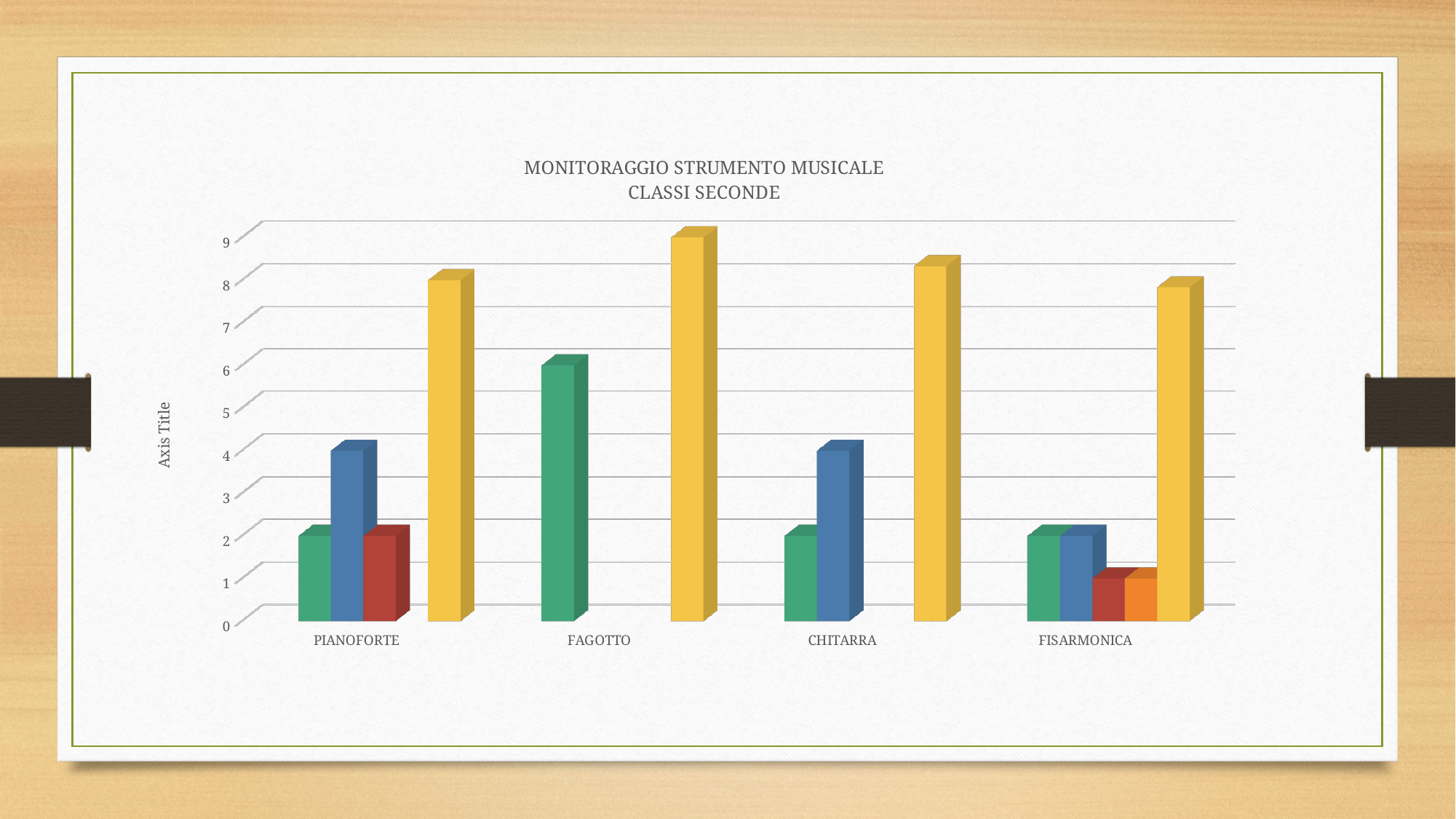
Which category contains the tallest bar in the chart? FAGOTTO Is the value of the green bar for FAGOTTO greater or less than 5? greater How many categories are shown on the x axis of the chart? 4 Is the value of the blue bar for PIANOFORTE greater or less than 3? greater What kind of chart is shown on the slide? bar chart What is the title of the chart? MONITORAGGIO STRUMENTO MUSICALE CLASSI SECONDE Is the value of the yellow bar for FAGOTTO greater or less than 8? greater What is the label on the vertical axis of the chart? Axis Title Which category has the larger green bar: FAGOTTO or CHITARRA? FAGOTTO For PIANOFORTE, which is larger: the blue bar or the green bar? the blue bar